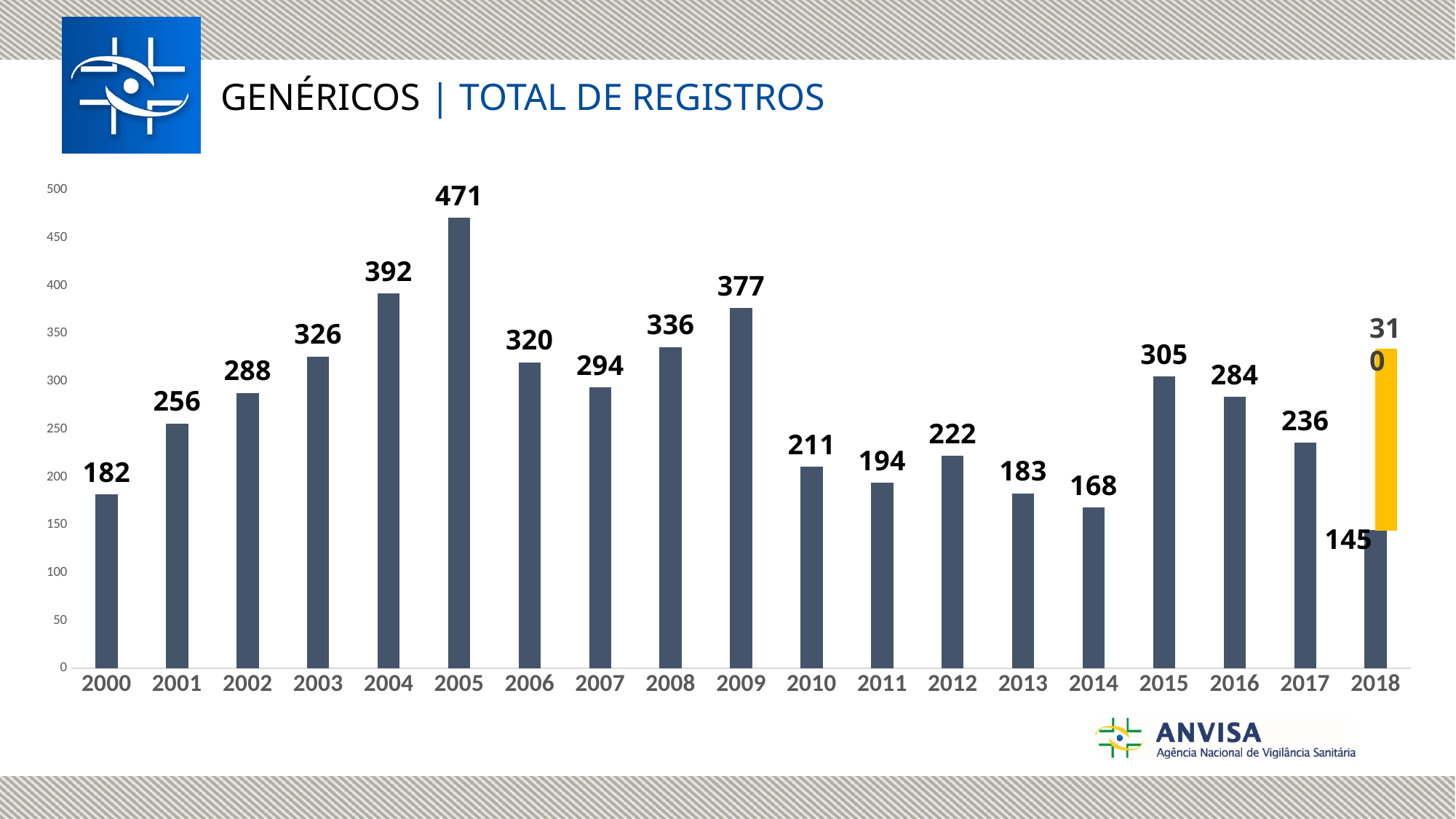
What kind of chart is shown on the slide? bar chart What is the value for 2005? 471 Which year has the highest value? 2005 What is the difference between the values for 2016 and 2017? 48 What is the value for 2011? 194 Which is larger, the value for 2008 or the value for 2009? 2009 How many years are shown on the x axis? 19 What is the value for 2009? 377 What is the difference between the values for 2005 and 2004? 79 Do the values rise or fall from 2000 to 2005? rise What is the value for 2014? 168 Among the years 2000 to 2017, which year has the lowest value? 2014